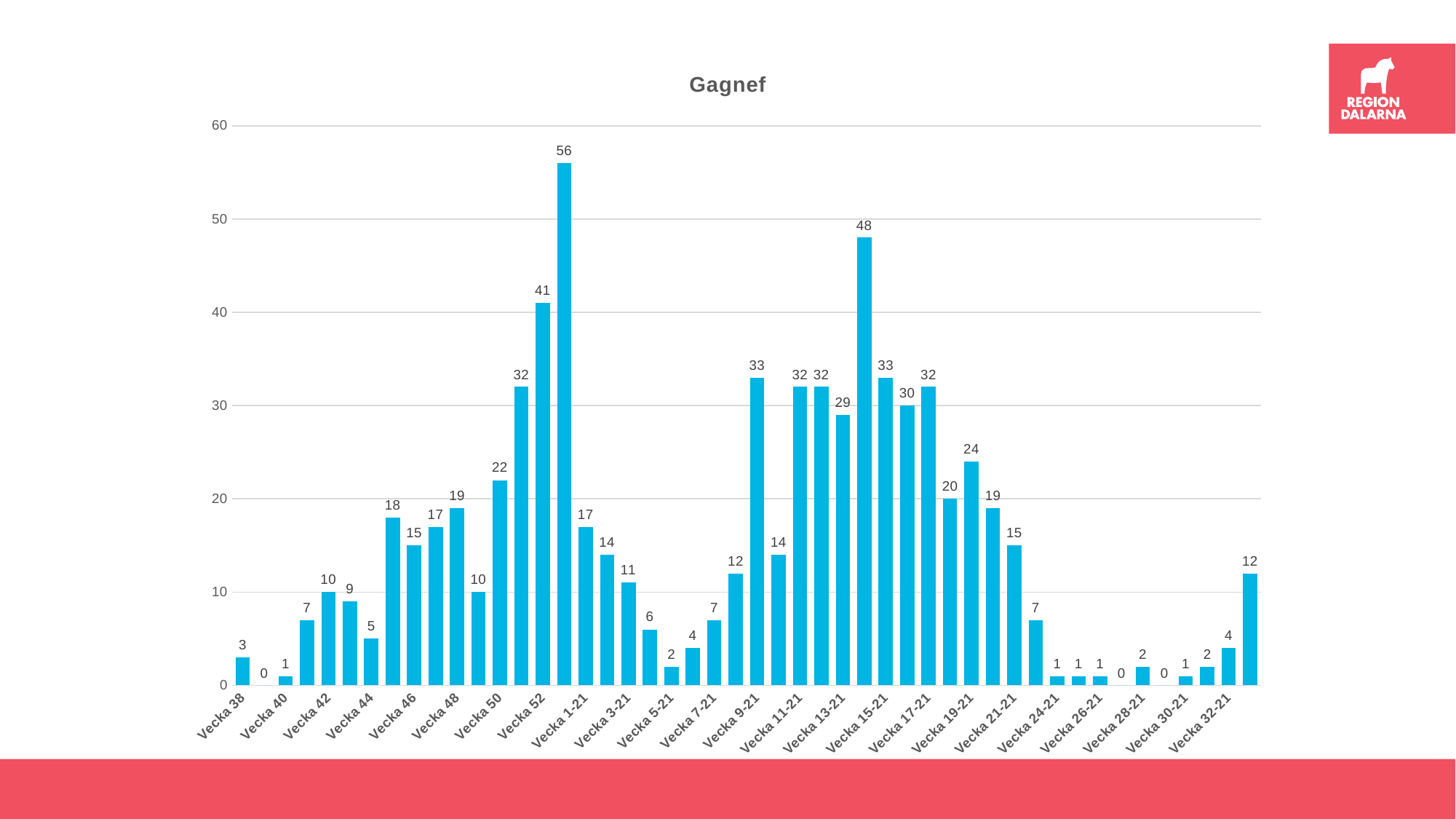
What is the highest value shown on the chart? 56 What is the value for Vecka 32-21? 4 Which has the larger value, Vecka 9-21 or Vecka 13-21? Vecka 9-21 How many bars are plotted on the chart? 48 What kind of chart is shown on the slide? bar chart What is the value for Vecka 52? 41 What is the value for Vecka 50? 22 Is the value for Vecka 19-21 greater or less than 20? greater What is the difference between the values for Vecka 52 and Vecka 50? 19 What is the value for Vecka 15-21? 33 Do the values rise or fall from Vecka 1-21 to Vecka 5-21? fall What is the title of the chart? Gagnef